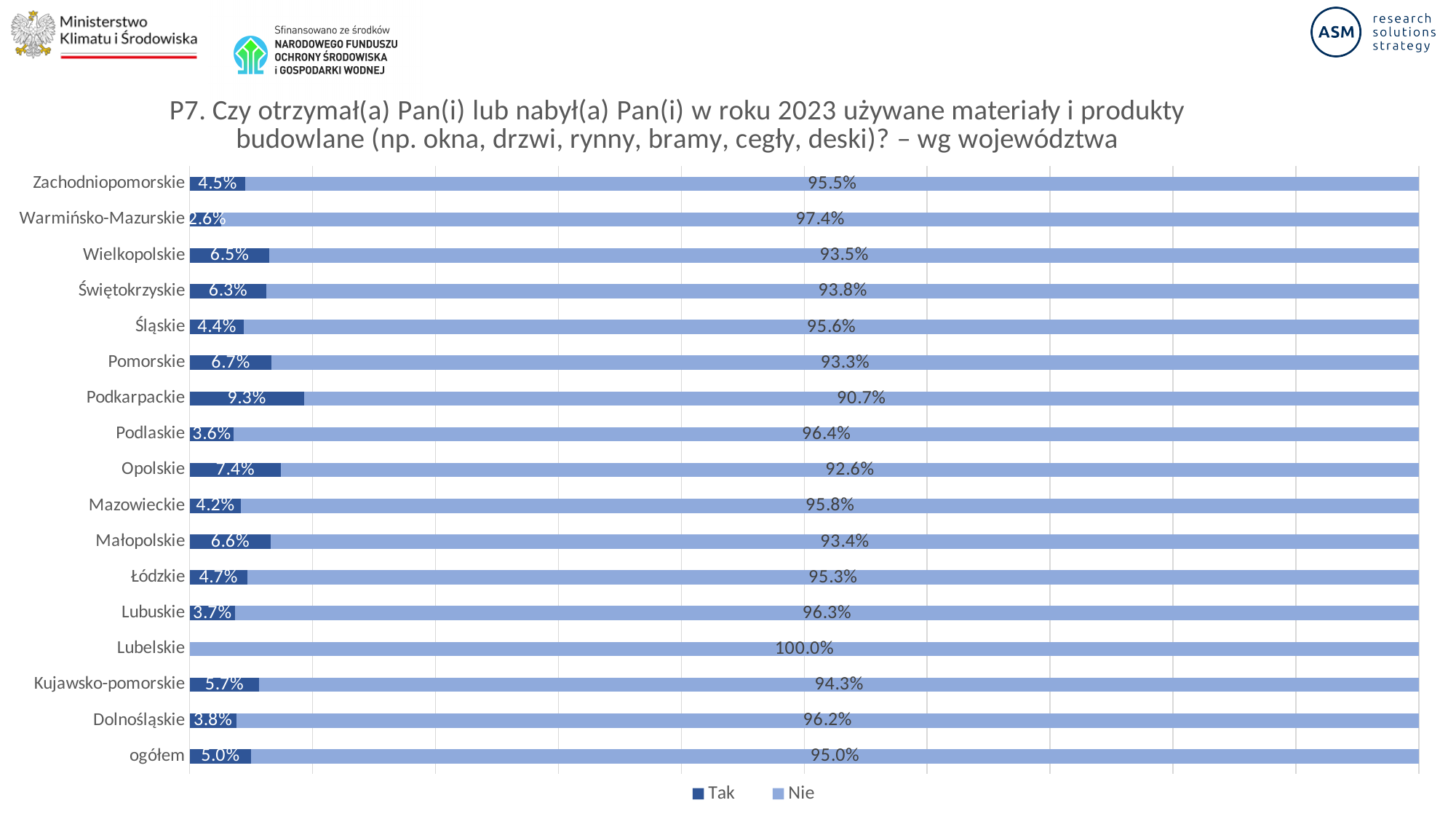
What is the 'Nie' value for Warmińsko-Mazurskie? 97.4% What are the two legend entries of the chart? Tak and Nie How many categories are shown on the y axis? 17 Which category has the highest 'Nie' value? Lubelskie Which has a larger 'Tak' value, Opolskie or Pomorskie? Opolskie What kind of chart is shown on the slide? Stacked bar chart What is the difference between the 'Tak' values for Podkarpackie and Śląskie? 4.9% How many series does the legend list? 2 What is the 'Tak' value for ogółem? 5.0% Which voivodeship has the highest 'Tak' value? Podkarpackie Which voivodeship has the lowest 'Tak' value among those with a 'Tak' label shown? Warmińsko-Mazurskie What is the 'Tak' value for Podkarpackie? 9.3%